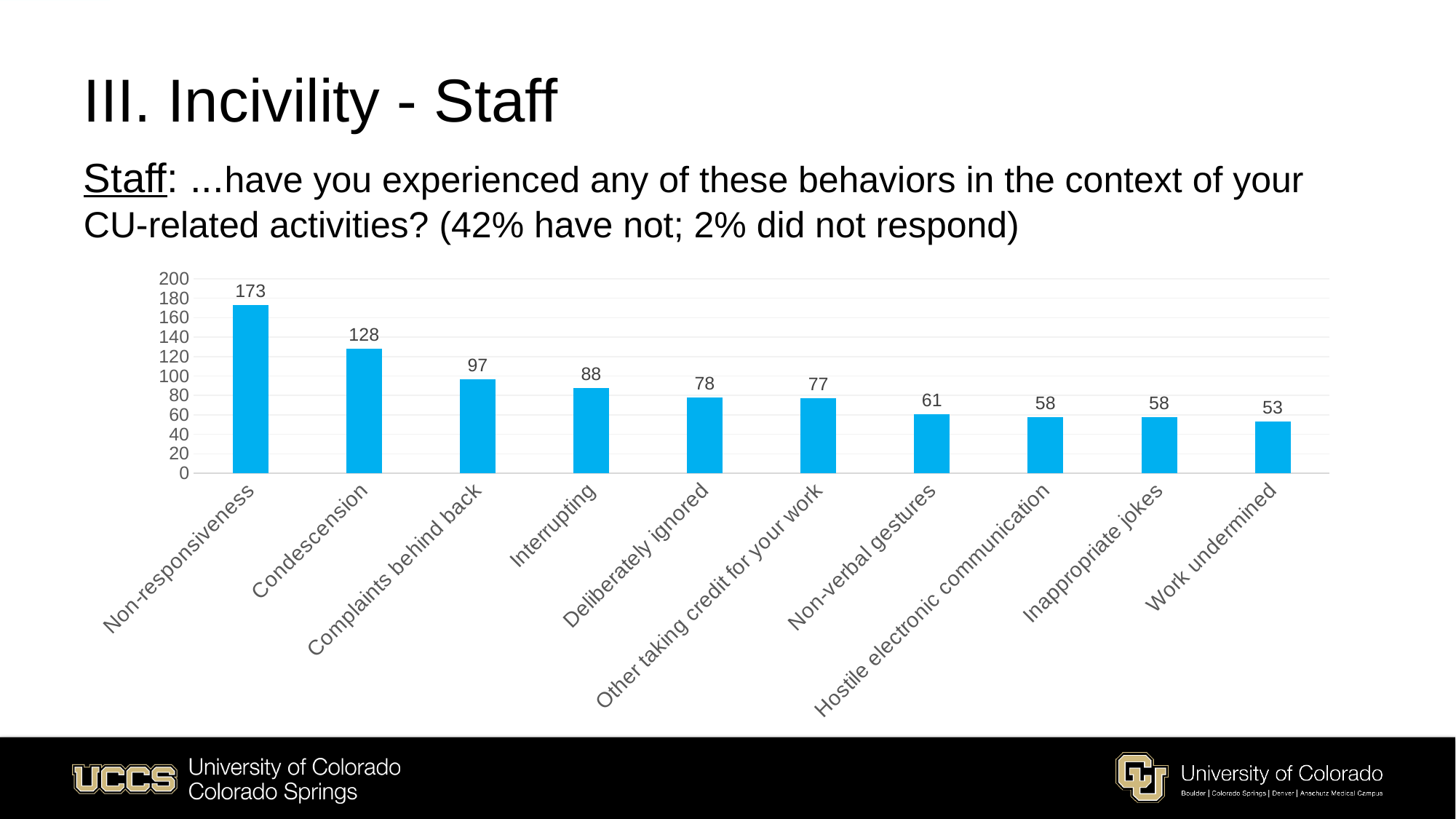
What is the value for Work undermined? 53 Do the values rise or fall from left to right across the categories? fall What is the value for Condescension? 128 What is the value for Other taking credit for your work? 77 Which behavior has the lowest value? Work undermined Which behavior has the highest value? Non-responsiveness Is the value for Complaints behind back greater or less than 80? greater What kind of chart is shown on the slide? bar chart Which is larger, the value for Interrupting or the value for Deliberately ignored? Interrupting How many behavior categories are shown in the chart? 10 What is the value for Non-responsiveness? 173 What is the difference between the values for Non-responsiveness and Condescension? 45